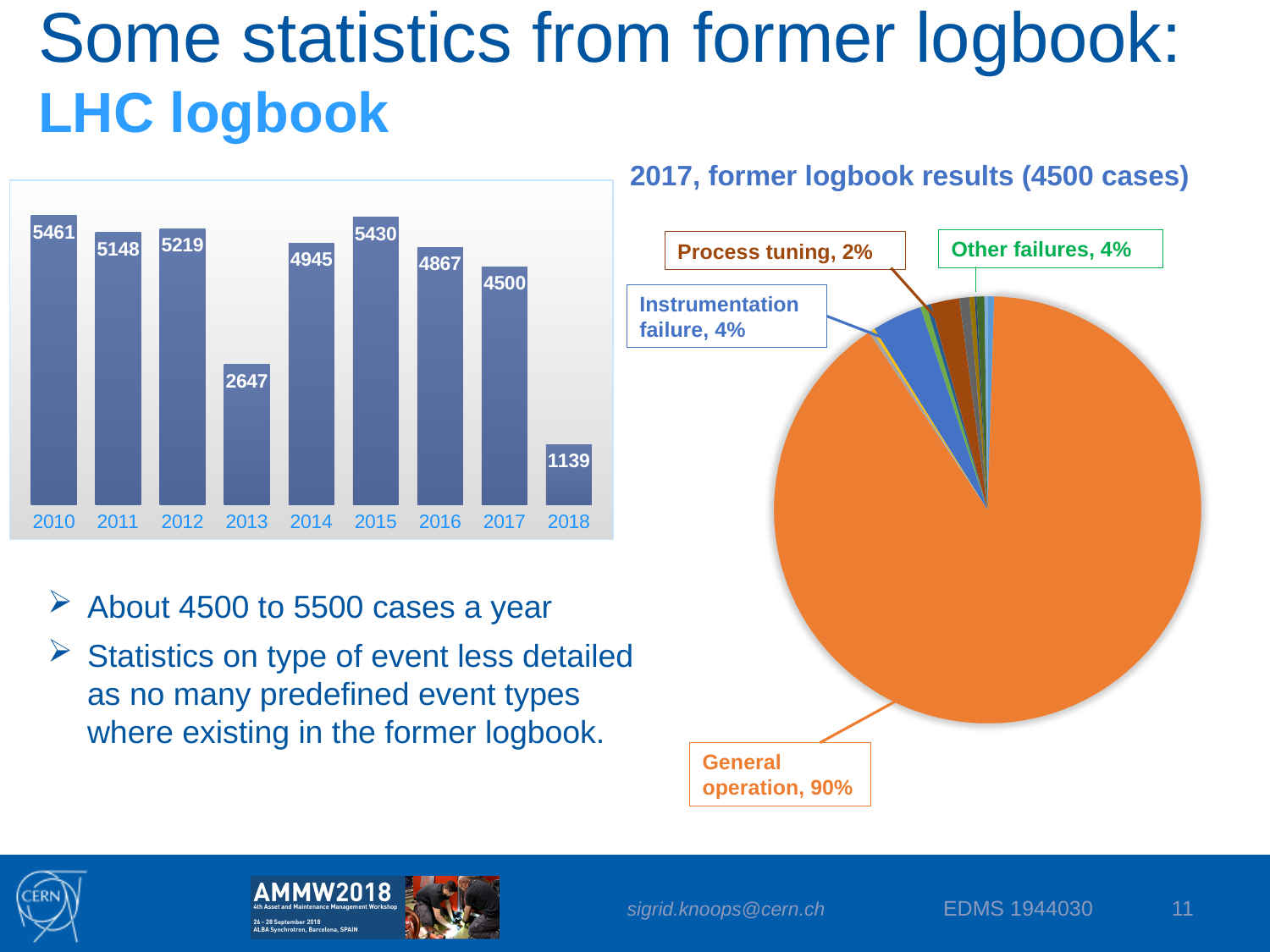
In the bar chart on the left, what is the difference between the values for 2015 and 2016? 563 In the bar chart on the left, what is the value for 2013? 2647 In the bar chart on the left, what is the value for 2017? 4500 In the bar chart on the left, which year has the highest value? 2010 What kind of chart is the chart on the left of the slide? bar chart In the bar chart on the left, which year has the lowest value? 2018 What kind of chart is the chart titled '2017, former logbook results (4500 cases)'? pie chart In the bar chart on the left, which is larger, the value for 2011 or the value for 2012? 2012 In the chart titled '2017, former logbook results (4500 cases)', which category has the largest share? General operation In the chart titled '2017, former logbook results (4500 cases)', what share does General operation have? 90% How many years are shown in the bar chart on the left? 9 In the chart titled '2017, former logbook results (4500 cases)', what share does Process tuning have? 2%